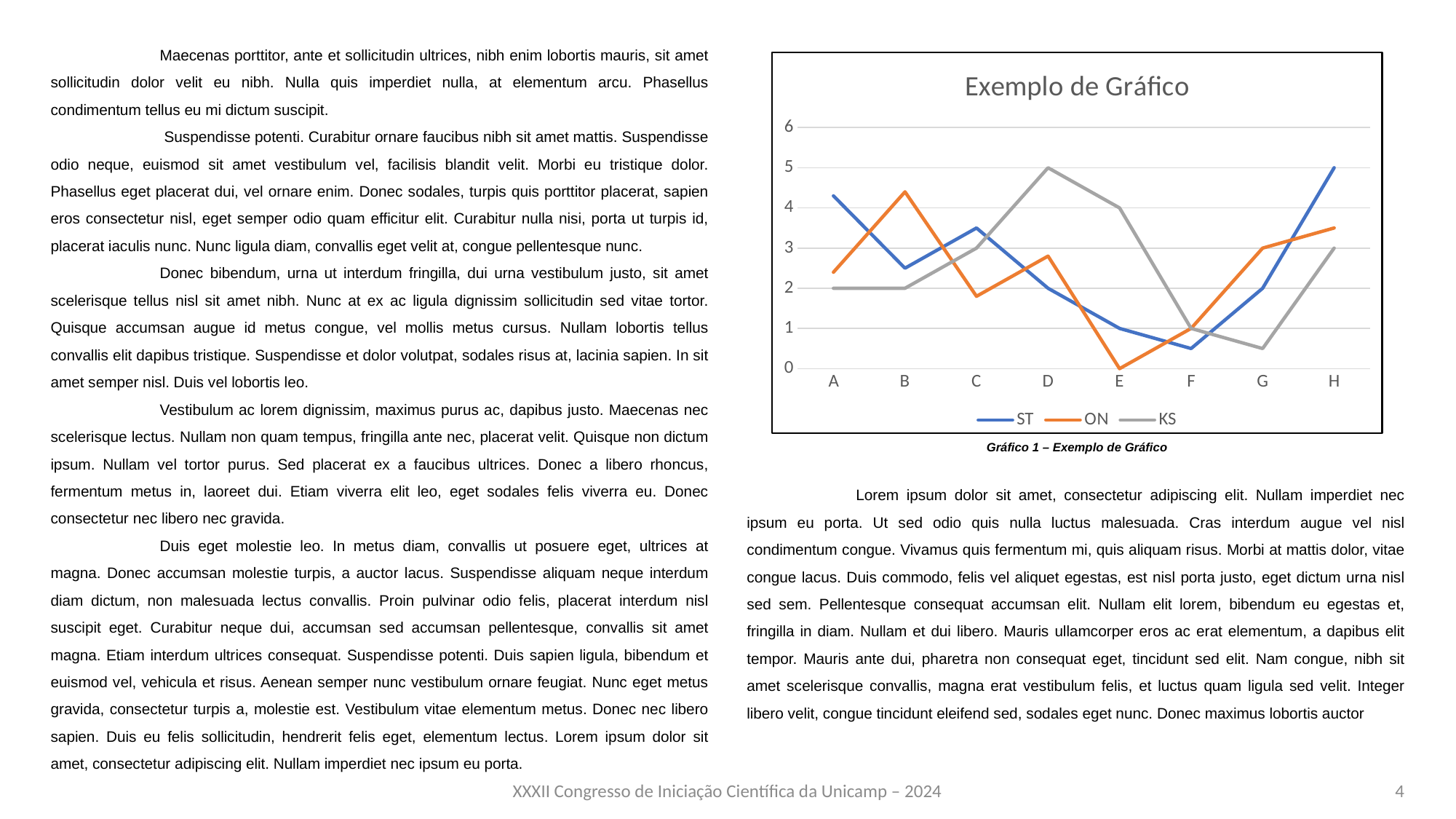
Does the ST series rise or fall from category F to category H? rise What is the title of the chart? Exemplo de Gráfico What kind of chart is shown on the slide? line chart Is the value of the ST series at category A greater or less than 4? greater What is the value of the KS series at category D? 5 What is the value of the ON series at category E? 0 How many categories are shown on the x axis of the chart? 8 How many series does the chart legend list? 3 Which series has the larger value at category B, ST or ON? ON At which category does the KS series reach its highest value? D At which category does the ON series reach its lowest value? E What is the value of the ST series at category H? 5